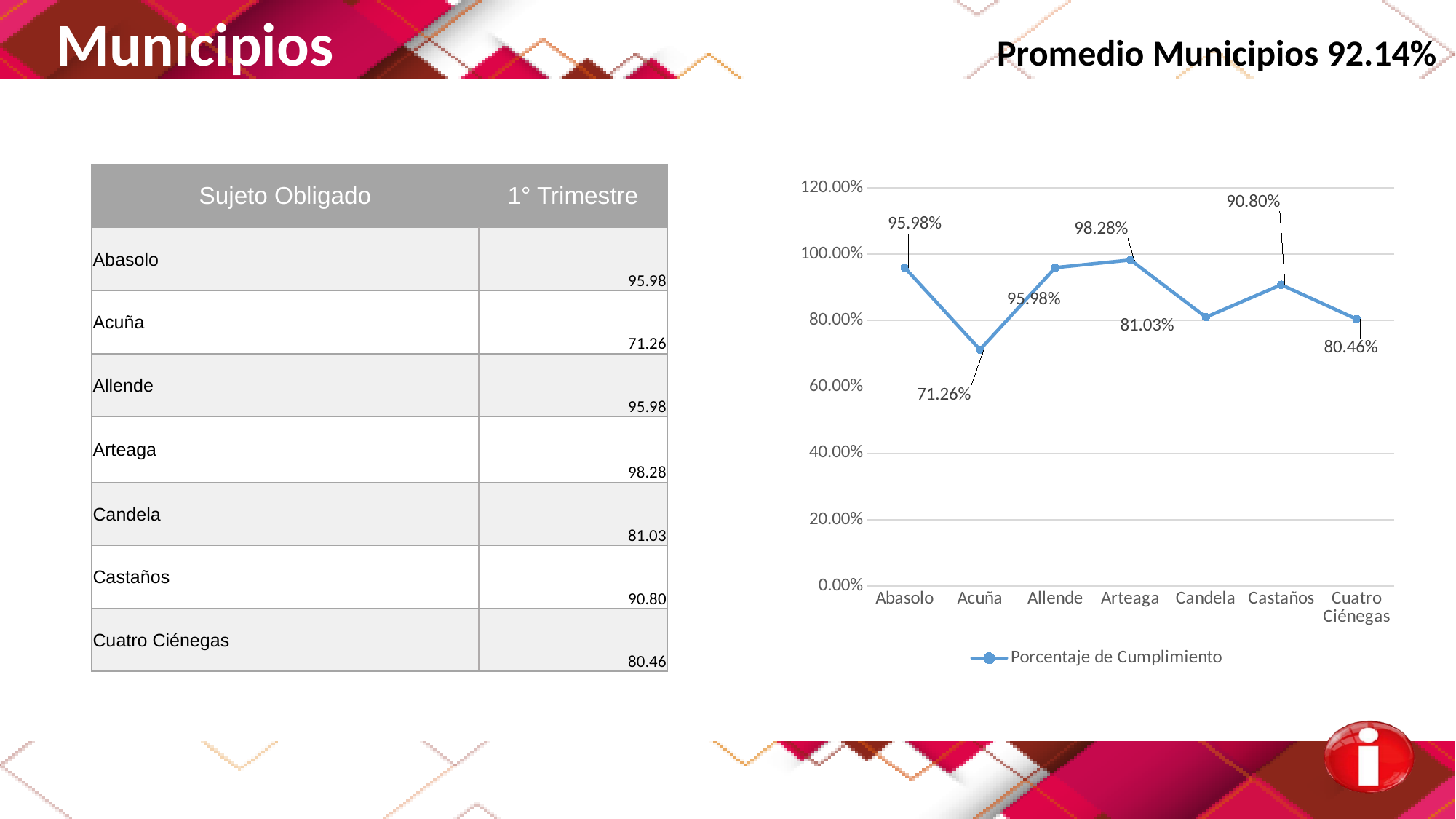
Is the value for Acuña greater or less than 80.00%? less Which has a higher Porcentaje de Cumplimiento, Castaños or Candela? Castaños What is the Porcentaje de Cumplimiento for Cuatro Ciénegas? 80.46% Which municipality has the highest Porcentaje de Cumplimiento? Arteaga What kind of chart is shown on the slide? line chart What is the difference between the values for Arteaga and Acuña? 27.02% Which municipality has the lowest Porcentaje de Cumplimiento? Acuña What is the name of the series shown in the legend? Porcentaje de Cumplimiento How many series does the legend list? 1 What is the Porcentaje de Cumplimiento for Acuña? 71.26% How many municipalities are plotted on the chart? 7 What is the Porcentaje de Cumplimiento for Arteaga? 98.28%